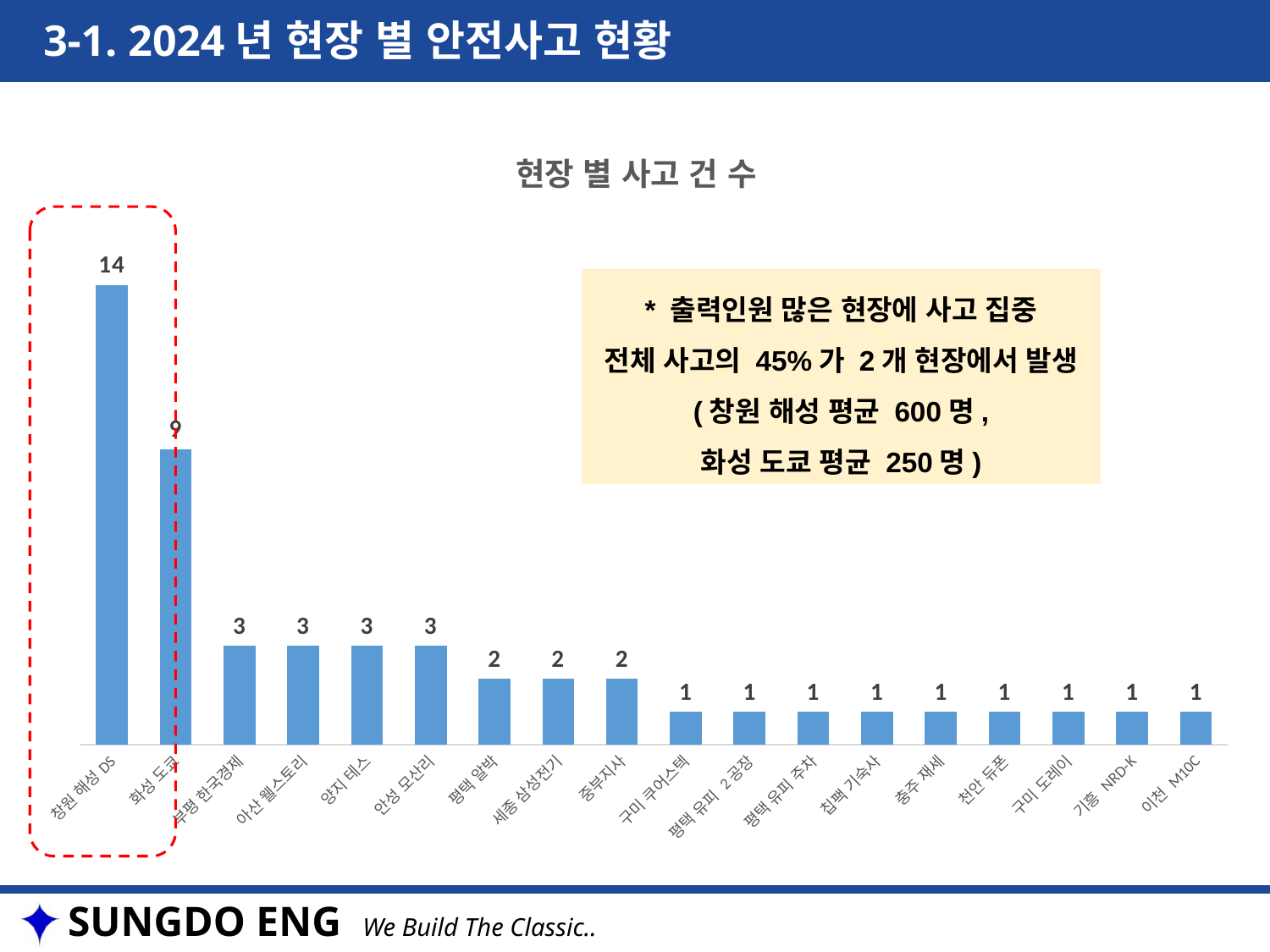
What is the value for 창원 해성 DS? 14 What is the lowest value shown on any bar in the chart? 1 How many sites (categories) are shown on the x axis? 18 What is the value for 화성 도쿄? 9 What is the value for 이천 M10C? 1 Which is larger, the value for 부평 한국경제 or the value for 중부지사? 부평 한국경제 What is the difference between the values for 창원 해성 DS and 화성 도쿄? 5 What kind of chart is shown on the slide? Bar chart Which site has the highest number of accidents? 창원 해성 DS What is the title of the chart? 현장 별 사고 건 수 Do the values rise or fall moving from left to right along the x axis? Fall What is the value for 평택 알박? 2